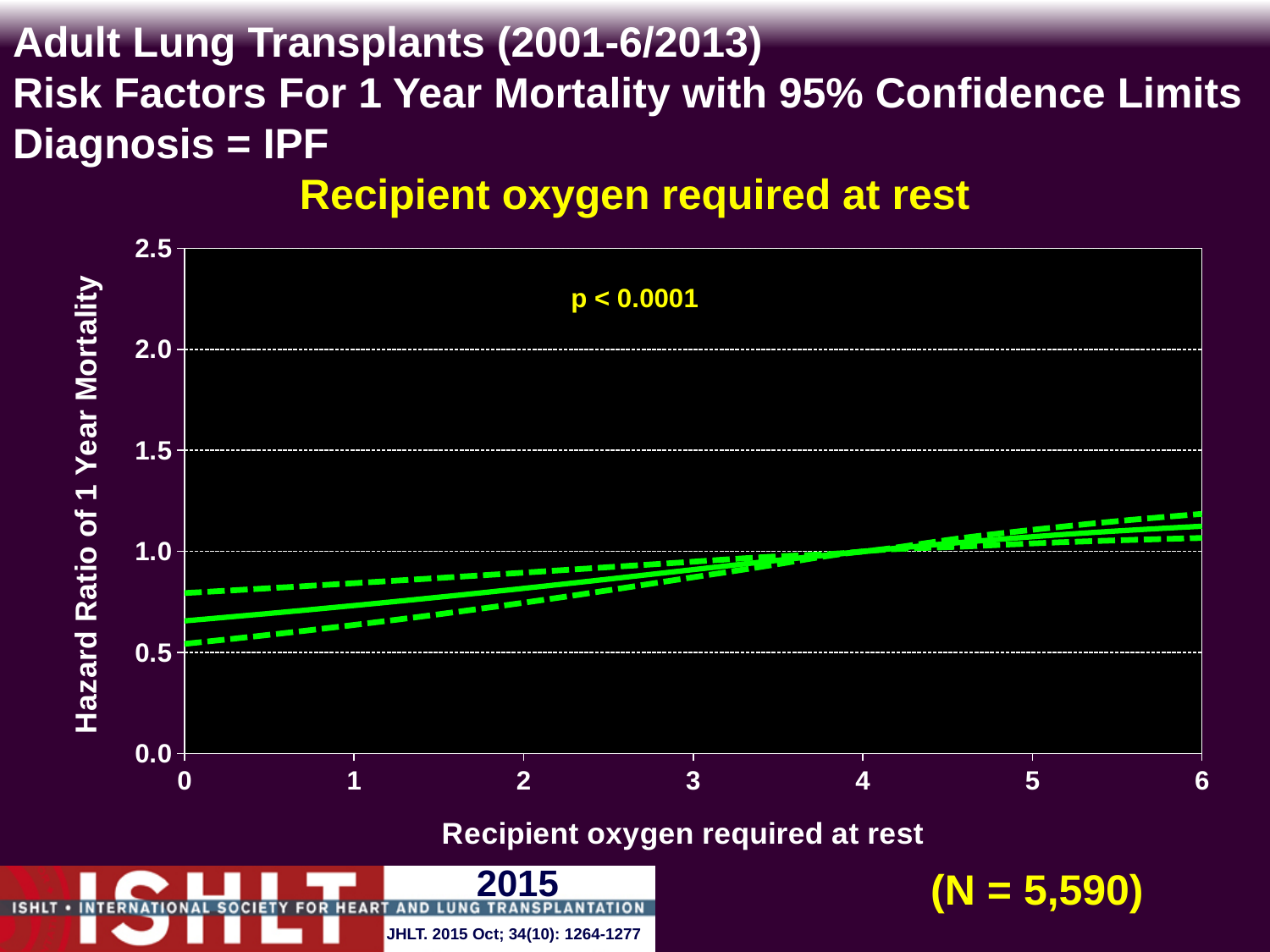
Is the upper 95% confidence limit (upper dashed line) at a recipient oxygen required at rest of 6 greater or less than 1.0? greater Does the hazard ratio of 1 year mortality rise or fall as recipient oxygen required at rest increases from 0 to 6? rise Is the hazard ratio (solid line) at a recipient oxygen required at rest of 0 greater or less than 0.5? greater Is the hazard ratio (solid line) at a recipient oxygen required at rest of 6 greater or less than 1.0? greater What p-value is printed on the chart? p < 0.0001 Which is larger: the hazard ratio at a recipient oxygen required at rest of 0 or at 6? 6 What is the label of the y axis? Hazard Ratio of 1 Year Mortality How many lines are plotted on the chart? 3 What kind of chart is shown on the slide? line chart